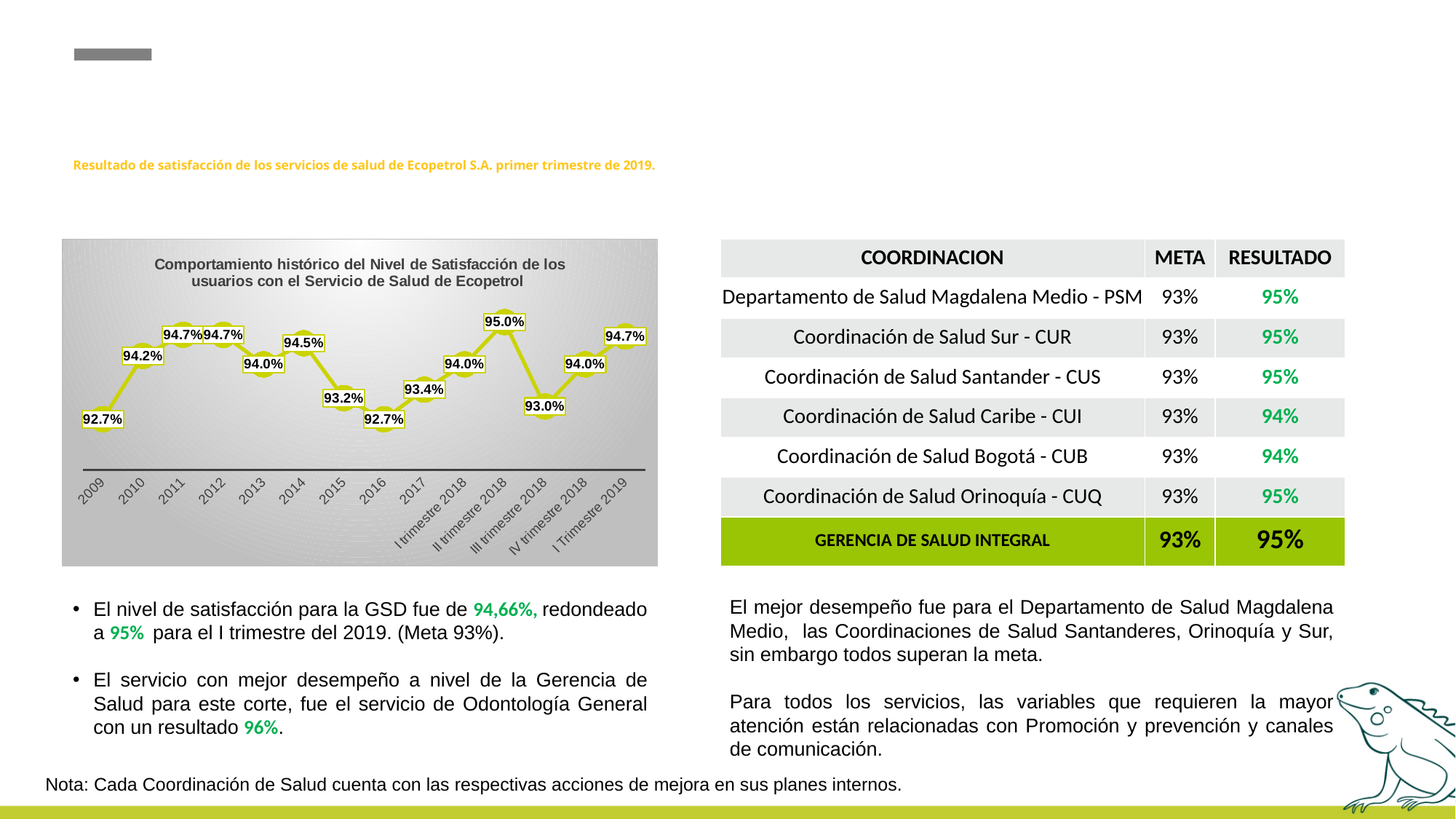
Which is larger, the value for 2014 or the value for 2017? 2014 What is the value shown for 2015? 93.2% What is the value shown for I Trimestre 2019? 94.7% What is the difference between the values for II trimestre 2018 and III trimestre 2018? 2.0% What is the title of the chart? Comportamiento histórico del Nivel de Satisfacción de los usuarios con el Servicio de Salud de Ecopetrol Which period has the highest satisfaction level in the chart? II trimestre 2018 What is the satisfaction level shown for 2009? 92.7% Does the satisfaction level rise or fall from 2009 to 2010? Rise How many data points are plotted in the chart? 14 What is the value shown for II trimestre 2018? 95.0% What is the lowest satisfaction value shown in the chart? 92.7% What type of chart is shown on the slide? Line chart